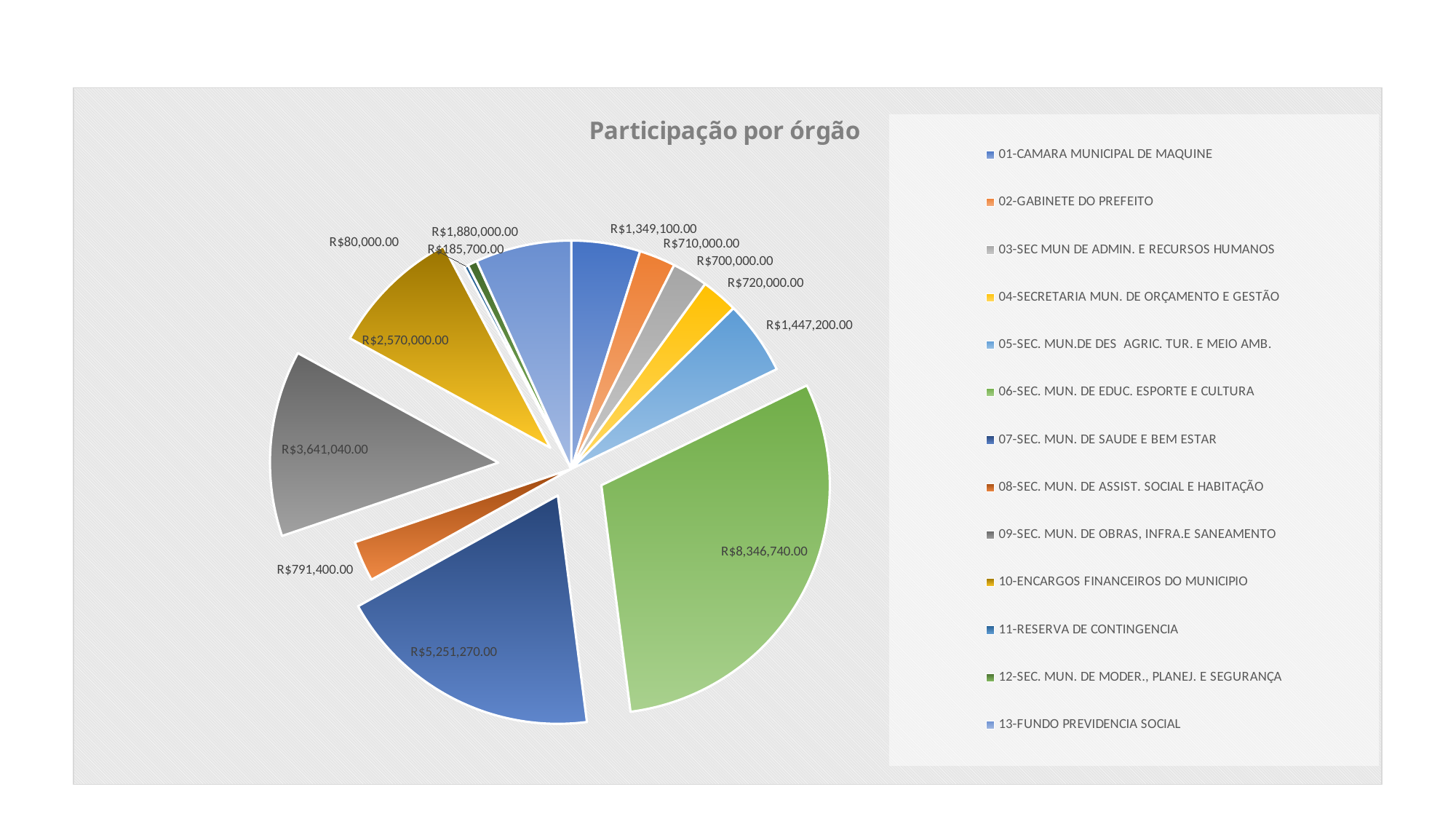
What is the smallest value labelled on the pie chart? R$80,000.00 What is the value for 10-ENCARGOS FINANCEIROS DO MUNICIPIO? R$2,570,000.00 What is the value for 09-SEC. MUN. DE OBRAS, INFRA.E SANEAMENTO? R$3,641,040.00 Which category has the largest slice of the pie? 06-SEC. MUN. DE EDUC. ESPORTE E CULTURA What is the value for 01-CAMARA MUNICIPAL DE MAQUINE? R$1,349,100.00 Which is larger, the value for 05-SEC. MUN.DE DES AGRIC. TUR. E MEIO AMB. or the value for 01-CAMARA MUNICIPAL DE MAQUINE? 05-SEC. MUN.DE DES AGRIC. TUR. E MEIO AMB. What is the value for 07-SEC. MUN. DE SAUDE E BEM ESTAR? R$5,251,270.00 What is the title of the chart? Participação por órgão What is the difference between the values for 06-SEC. MUN. DE EDUC. ESPORTE E CULTURA and 07-SEC. MUN. DE SAUDE E BEM ESTAR? R$3,095,470.00 What is the value for 06-SEC. MUN. DE EDUC. ESPORTE E CULTURA? R$8,346,740.00 What type of chart is shown on the slide? pie chart How many categories does the legend list? 13